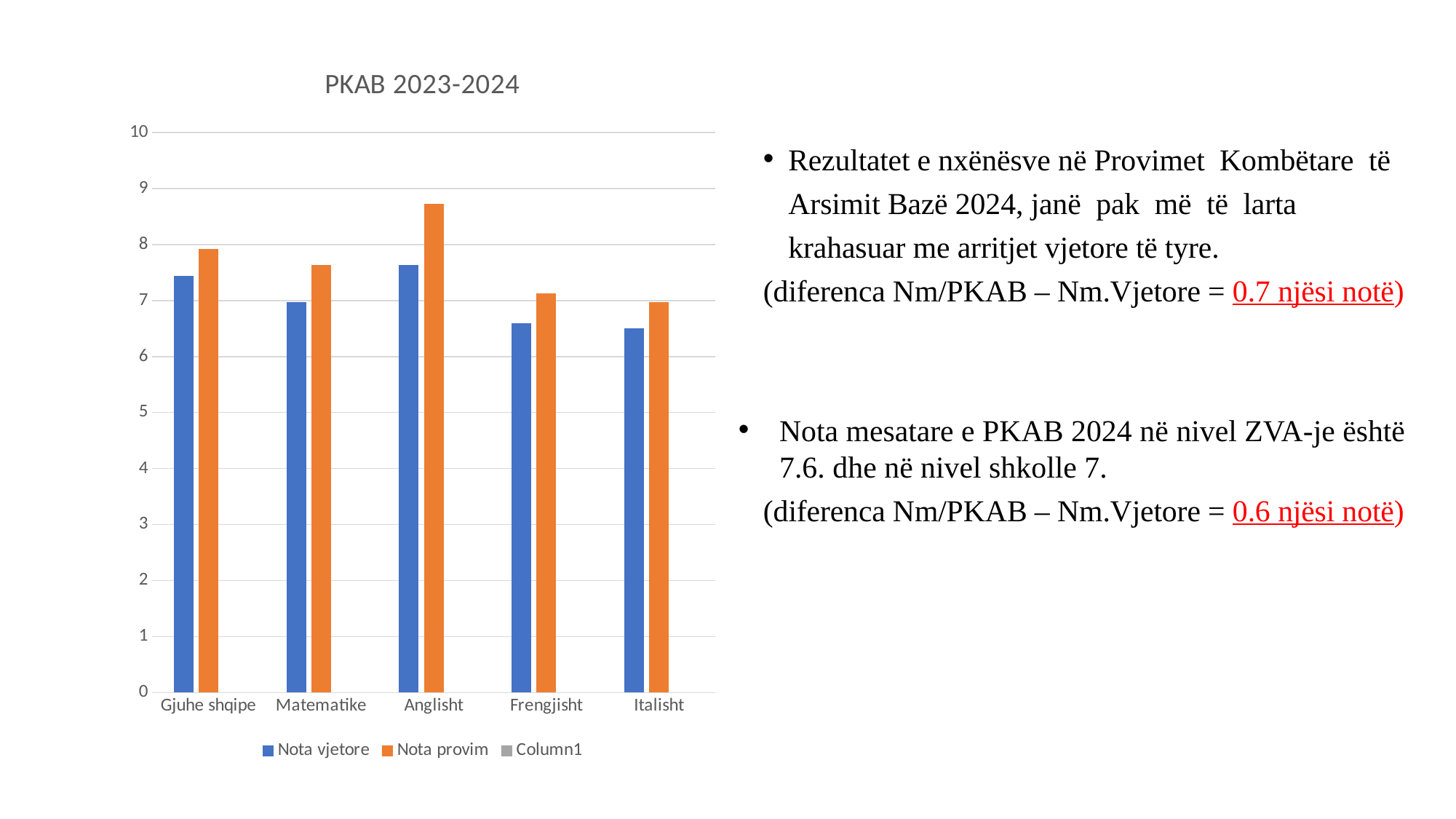
How many series does the chart legend list? 3 Is the Nota provim value for Anglisht greater or less than 8? greater Which colour represents the Nota provim series in the chart? orange Is the Nota vjetore value for Gjuhe shqipe greater or less than 7? greater Is the Nota vjetore value for Frengjisht greater or less than 7? less For Anglisht, which is larger: Nota vjetore or Nota provim? Nota provim Which is larger: the Nota provim value for Gjuhe shqipe or the Nota provim value for Matematike? Gjuhe shqipe What is the title of the chart? PKAB 2023-2024 Which subject has the highest Nota provim value? Anglisht What type of chart is shown on the slide? bar chart How many subject categories are shown on the x axis of the chart? 5